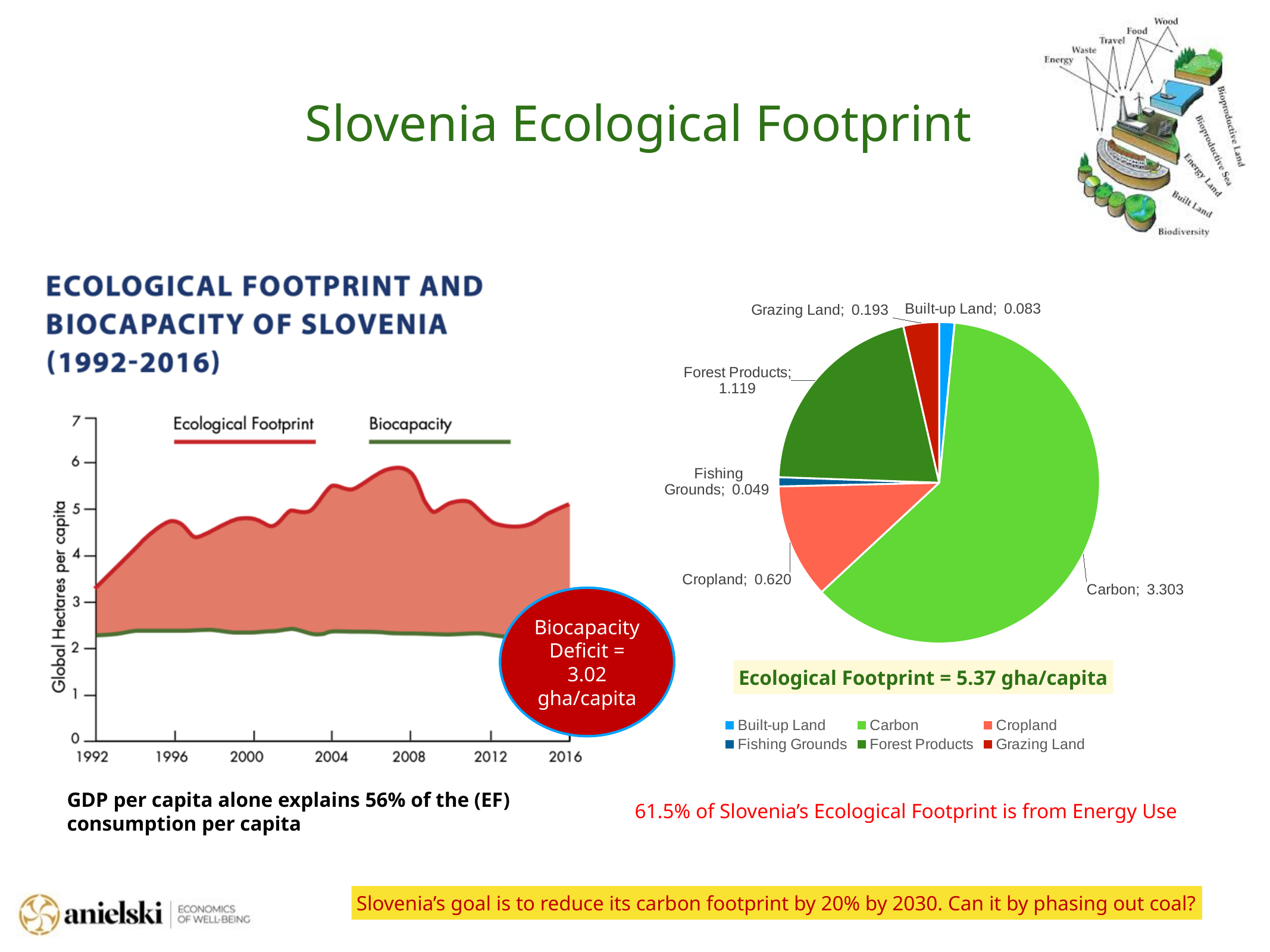
On the Ecological Footprint and Biocapacity of Slovenia chart, how many series does the legend list? 2 On the pie chart, what is the value for Carbon? 3.303 How many categories does the pie chart show? 6 On the pie chart, which is larger, Grazing Land or Built-up Land? Grazing Land On the Ecological Footprint and Biocapacity of Slovenia chart, is the Ecological Footprint value in 2008 greater or less than 5? greater What share of the pie chart does Carbon represent, as stated on the slide? 61.5% On the pie chart, what is the difference between the values for Forest Products and Cropland? 0.499 On the Ecological Footprint and Biocapacity of Slovenia chart, is the Biocapacity value in 2016 greater or less than 3? less On the pie chart, what is the value for Forest Products? 1.119 On the pie chart, what is the value for Fishing Grounds? 0.049 On the pie chart, which category has the largest slice? Carbon On the pie chart, which category has the smallest slice? Fishing Grounds